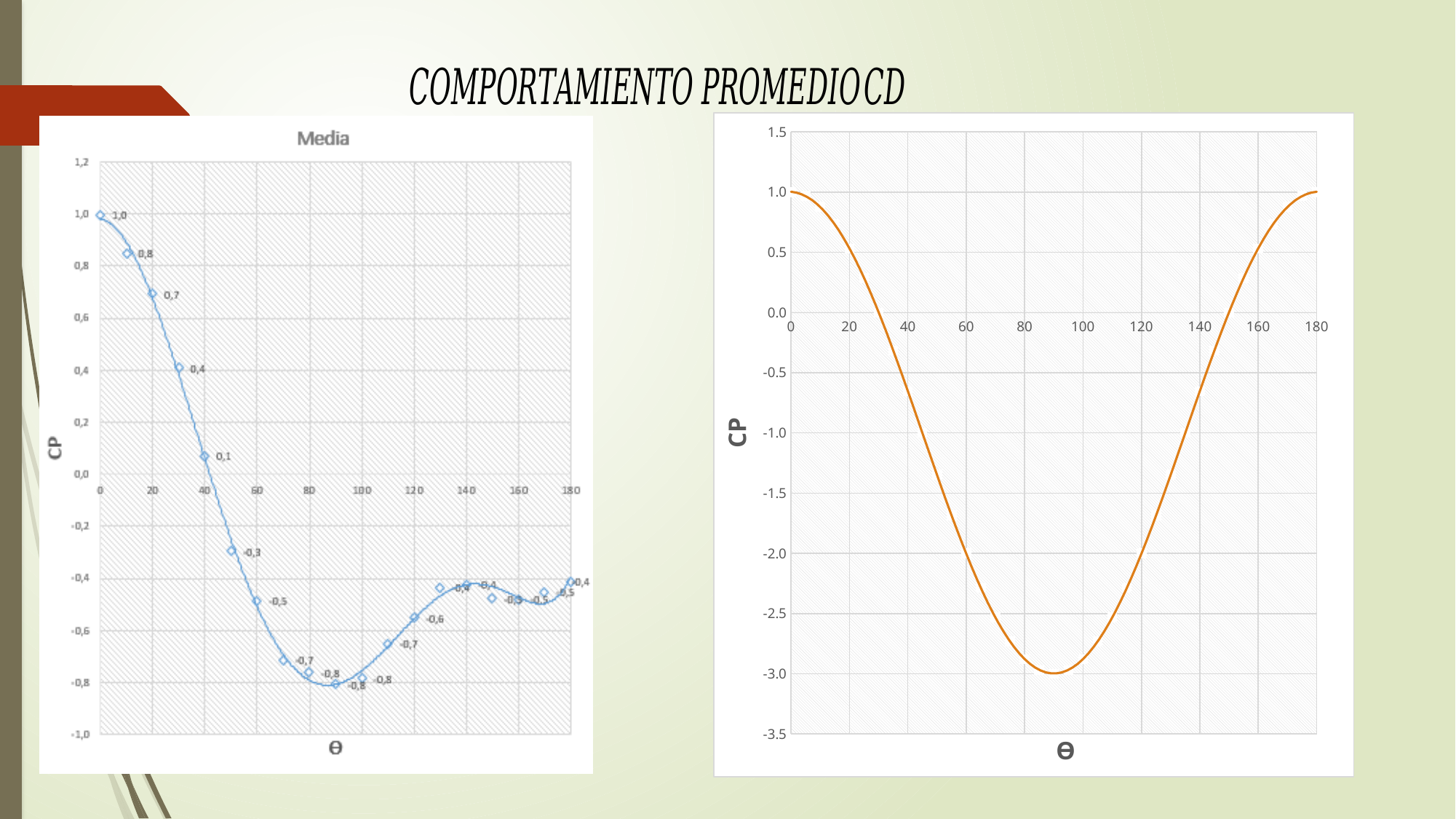
In the left chart titled "Media", which has the larger CP value, Θ = 10 or Θ = 40? Θ = 10 In the left chart titled "Media", what is the CP value at Θ = 120? -0,6 In the right chart, is the CP value at Θ = 20 greater or less than 0.0? greater What is the title of the left chart? Media In the left chart titled "Media", what is the CP value at Θ = 90? -0,8 In the left chart titled "Media", at which Θ value is CP highest? 0 In the right chart, is the CP value at Θ = 90 greater or less than -2.5? less In the right chart, do the CP values rise or fall as Θ goes from 100 to 180? rise In the left chart titled "Media", what is the CP value at Θ = 30? 0,4 In the left chart titled "Media", what is the difference between the CP value at Θ = 0 and the CP value at Θ = 20? 0,3 In the left chart titled "Media", do the CP values rise or fall as Θ goes from 0 to 80? fall In the left chart titled "Media", what is the CP value at Θ = 0? 1,0